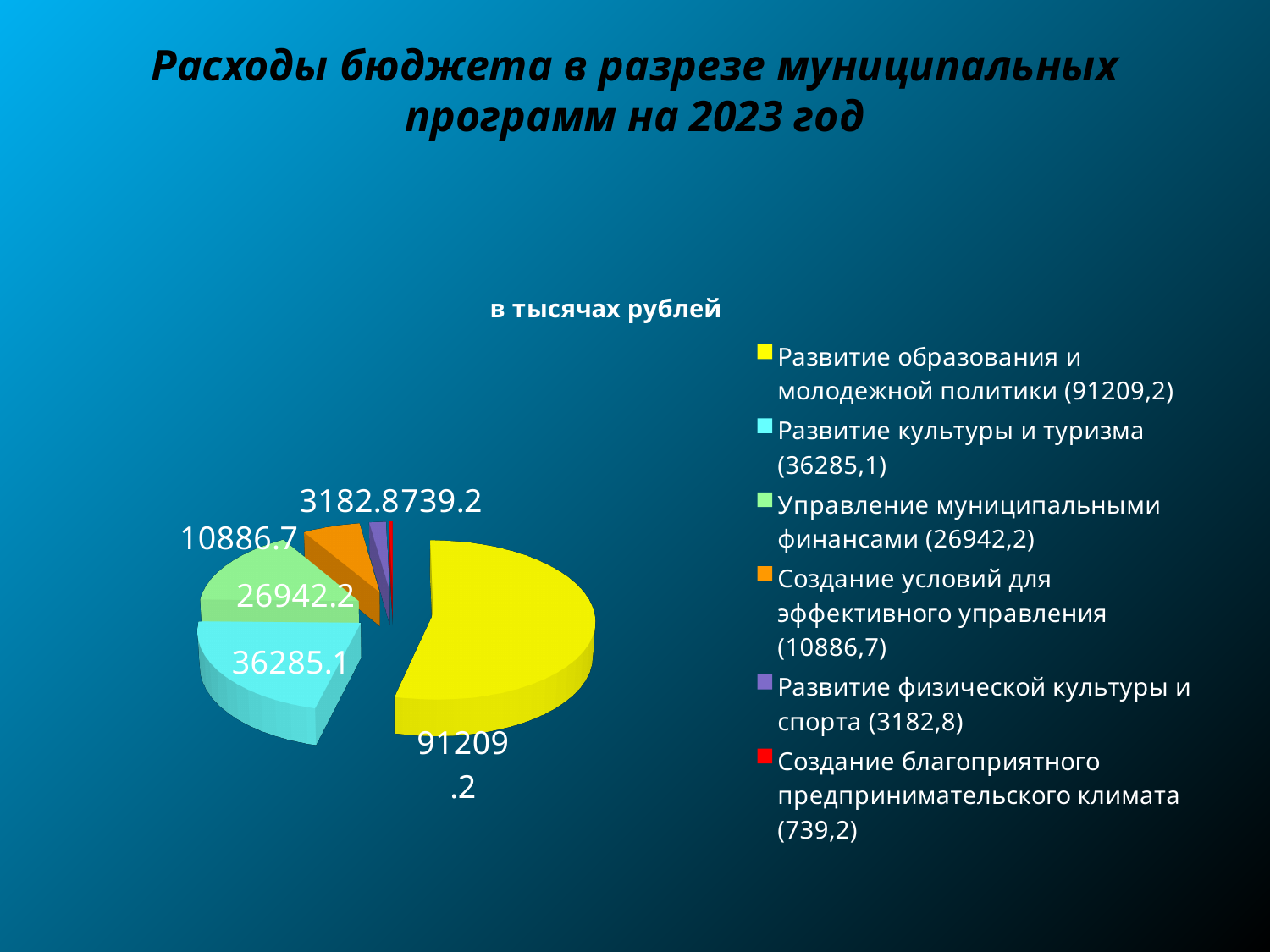
How many categories does the legend list? 6 What is the difference between the values for Развитие физической культуры и спорта and Создание благоприятного предпринимательского климата? 2443.6 What type of chart is shown on the slide? Pie chart What is the value for Создание благоприятного предпринимательского климата? 739.2 Which category has the largest slice of the pie? Развитие образования и молодежной политики What is the value for Развитие культуры и туризма? 36285.1 What is the value for Создание условий для эффективного управления? 10886.7 What is the difference between the values for Развитие образования и молодежной политики and Развитие культуры и туризма? 54924.1 What is the value for Развитие образования и молодежной политики? 91209.2 What is the value for Управление муниципальными финансами? 26942.2 Which is larger: Управление муниципальными финансами or Создание условий для эффективного управления? Управление муниципальными финансами Which category has the smallest slice of the pie? Создание благоприятного предпринимательского климата